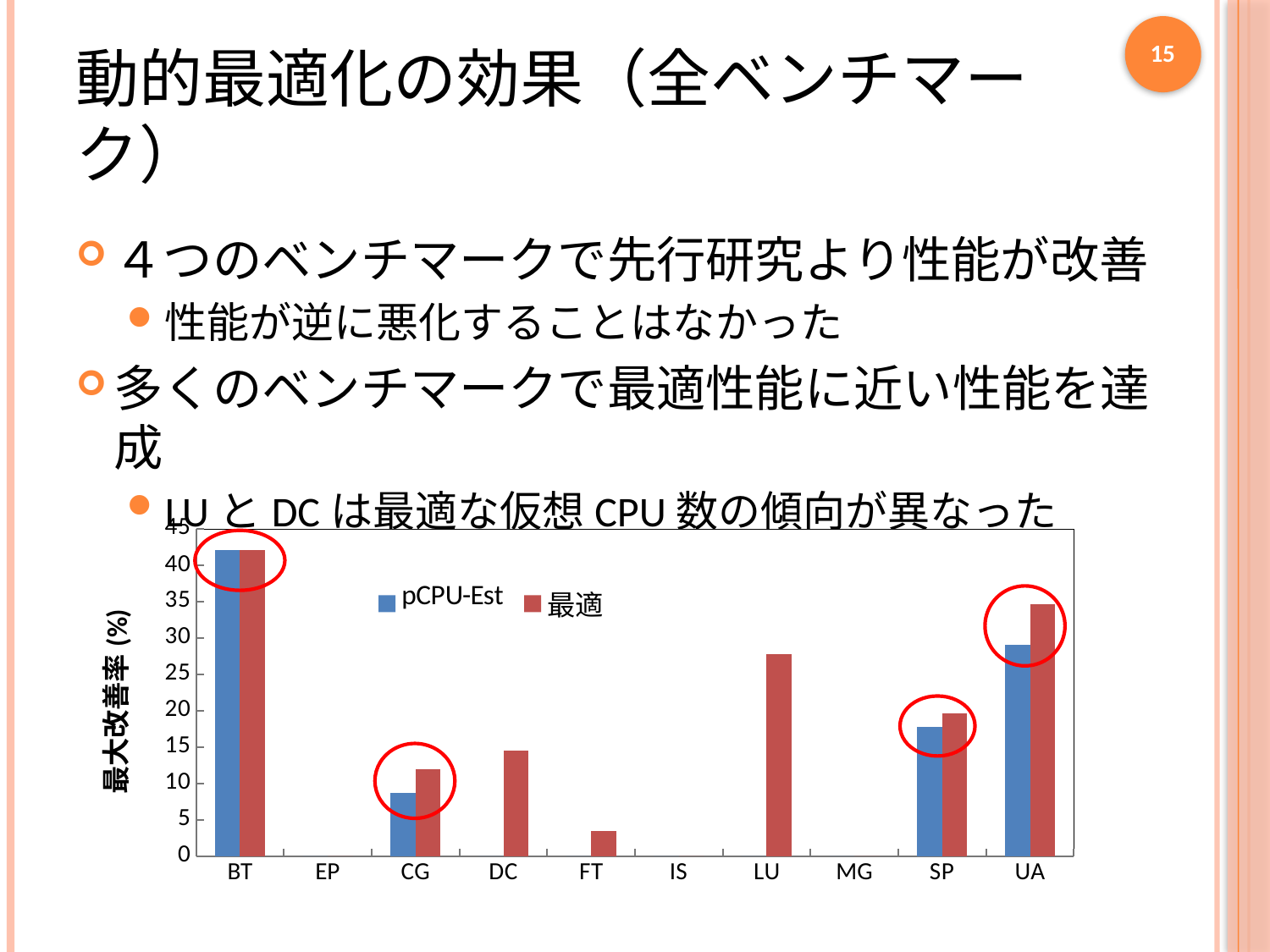
Which has the larger 最適 value, LU or DC? LU How many benchmark categories are shown on the x axis of the chart? 10 Which benchmark has the highest 最適 value in the chart? BT Is the 最適 value for FT greater or less than 5? less Is the pCPU-Est value for CG greater or less than 10? less How many series does the chart's legend list? 2 What is the label of the chart's vertical axis? 最大改善率 (%) Is the 最適 value for LU greater or less than 25? greater Which benchmark has the highest pCPU-Est value in the chart? BT What kind of chart is shown on the slide? bar chart For UA, which series has the larger value, pCPU-Est or 最適? 最適